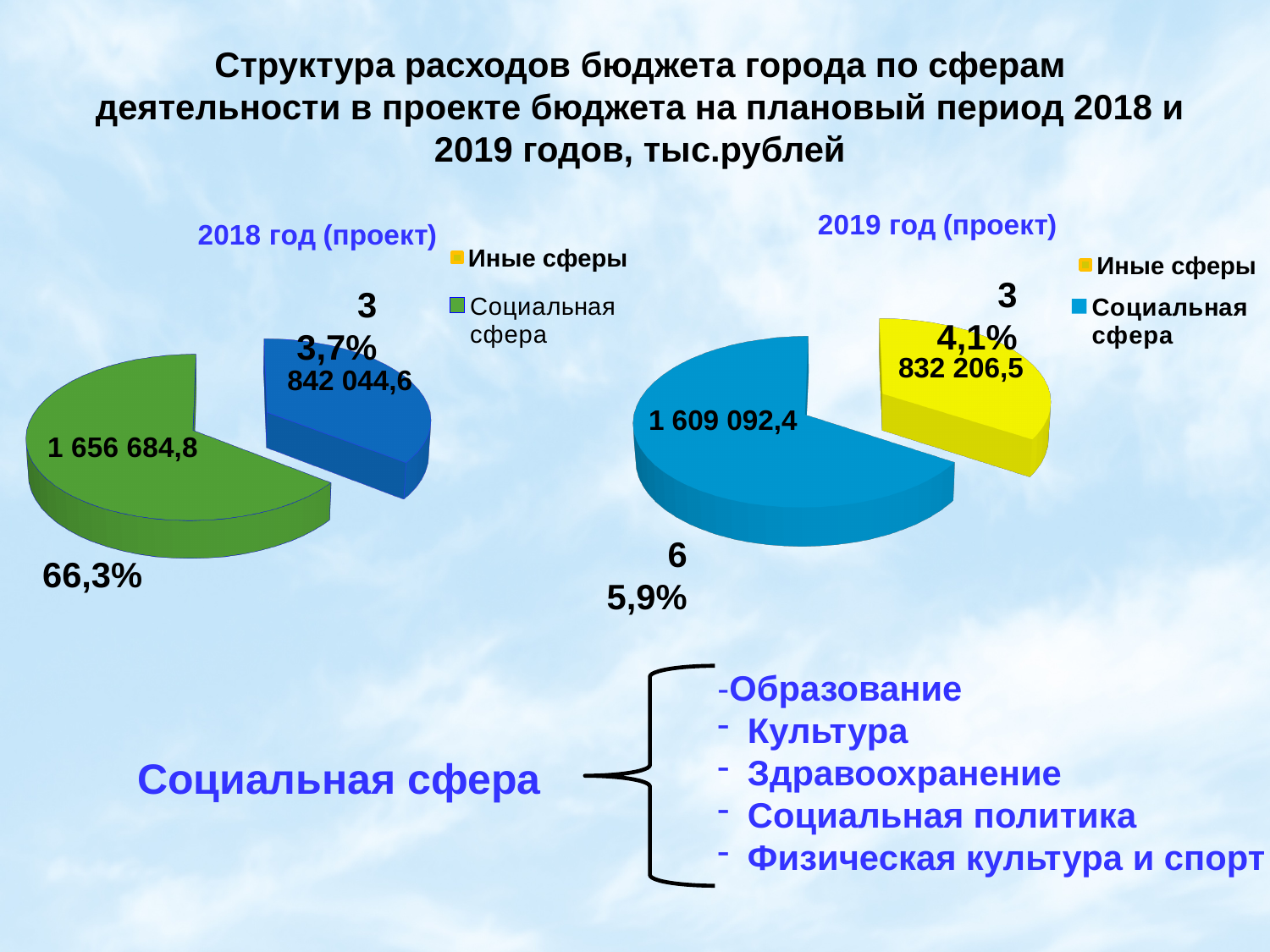
In the 2018 год (проект) chart, which category has the smallest slice? Иные сферы In the 2019 год (проект) chart, which category has the largest slice? Социальная сфера How many entries does the legend of the 2018 год (проект) chart list? 2 In the 2018 год (проект) chart, what is the difference between Социальная сфера and Иные сферы? 814 640,2 In the 2018 год (проект) chart, what is the value for Иные сферы? 842 044,6 How many categories does the 2019 год (проект) pie chart show? 2 Which is larger: Социальная сфера in the 2018 год (проект) chart or Социальная сфера in the 2019 год (проект) chart? 2018 год (проект) In the 2018 год (проект) chart, what is the value for Социальная сфера? 1 656 684,8 In the 2019 год (проект) chart, what is the value for Социальная сфера? 1 609 092,4 In the 2019 год (проект) chart, what is the total of the two slices? 2 441 298,9 What type of chart is used on this slide for the 2018 год (проект) data? pie chart In the 2019 год (проект) chart, what is the value for Иные сферы? 832 206,5